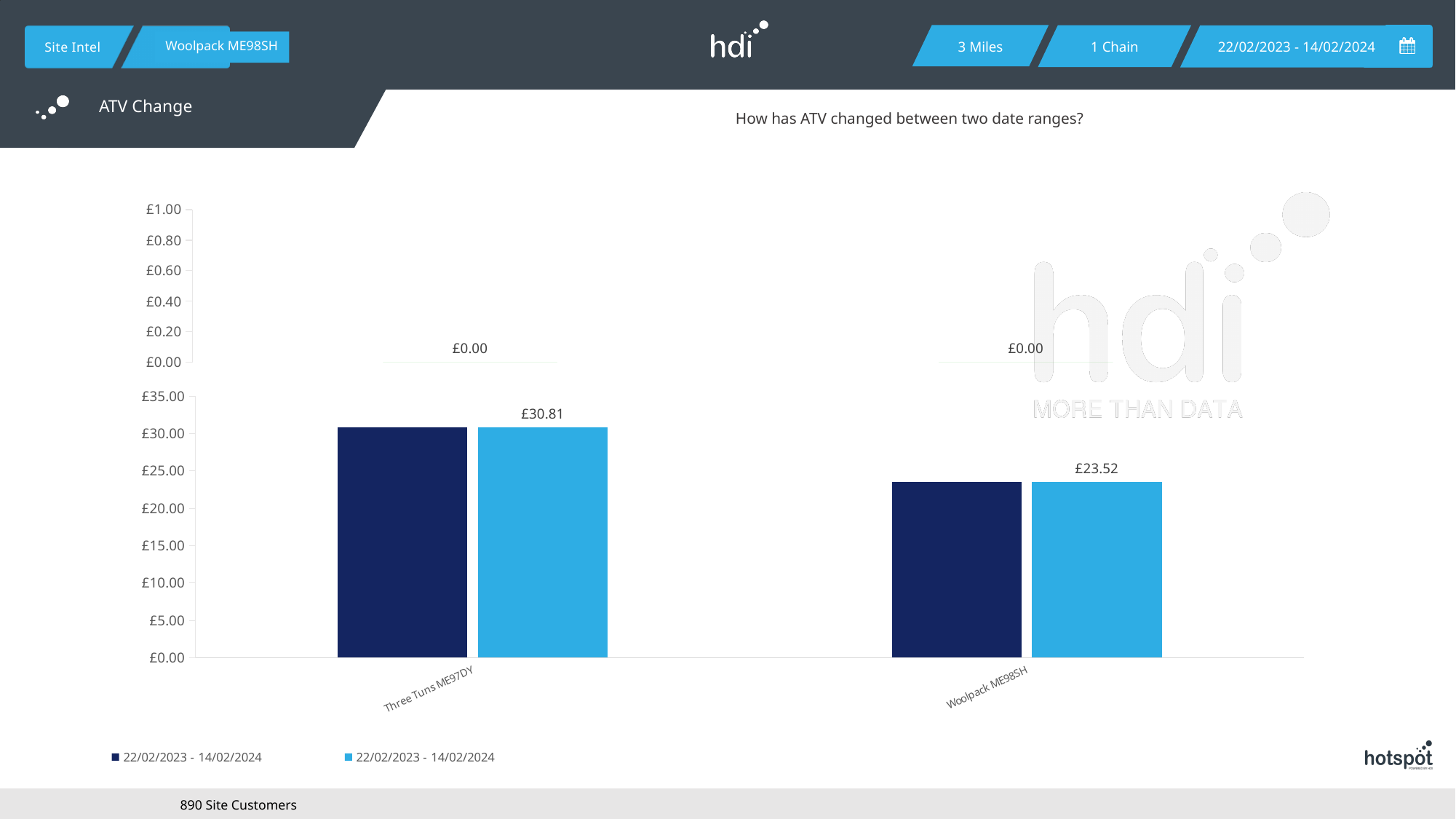
In the upper chart, what value is labelled for Three Tuns ME97DY? £0.00 In the lower chart, which site has the highest ATV? Three Tuns ME97DY How many sites are shown on the x axis of the chart? 2 In the lower chart, which site has the lowest ATV? Woolpack ME98SH In the lower chart, is the ATV for Three Tuns ME97DY greater or less than £25.00? greater In the lower chart, is the ATV for Woolpack ME98SH greater or less than £25.00? less In the lower chart, which is larger: the ATV for Three Tuns ME97DY or for Woolpack ME98SH? Three Tuns ME97DY What kind of chart is shown on the slide? bar chart In the lower chart, what is the ATV value labelled for Woolpack ME98SH? £23.52 How many series does the legend list? 2 In the lower chart, what is the ATV value labelled for Three Tuns ME97DY? £30.81 In the lower chart, what is the difference between the labelled ATV for Three Tuns ME97DY and Woolpack ME98SH? £7.29